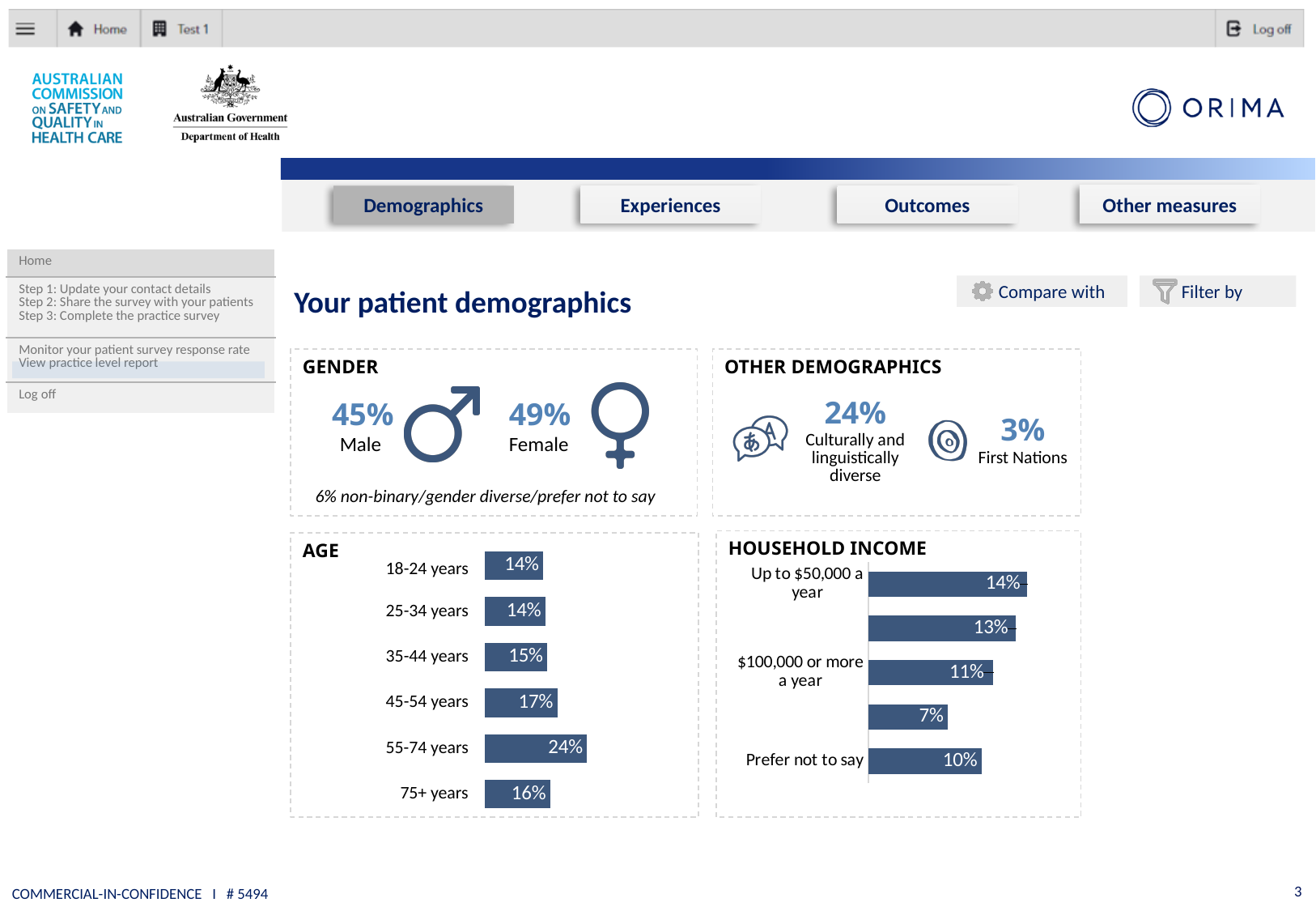
In the HOUSEHOLD INCOME chart, what is the value for 'Up to $50,000 a year'? 14% In the AGE chart, what is the value for 55-74 years? 24% In the AGE chart, what is the difference between the values for 55-74 years and 75+ years? 8% In the AGE chart, which age group has the highest value? 55-74 years How many bars are shown in the HOUSEHOLD INCOME chart? 5 In the AGE chart, what is the value for 45-54 years? 17% In the HOUSEHOLD INCOME chart, what is the value for 'Prefer not to say'? 10% In the AGE chart, which is larger, the value for 35-44 years or the value for 45-54 years? 45-54 years In the HOUSEHOLD INCOME chart, what is the value for '$100,000 or more a year'? 11% What kind of chart is the AGE chart? bar chart How many age groups are shown in the AGE chart? 6 In the HOUSEHOLD INCOME chart, what is the difference between the values for 'Up to $50,000 a year' and 'Prefer not to say'? 4%